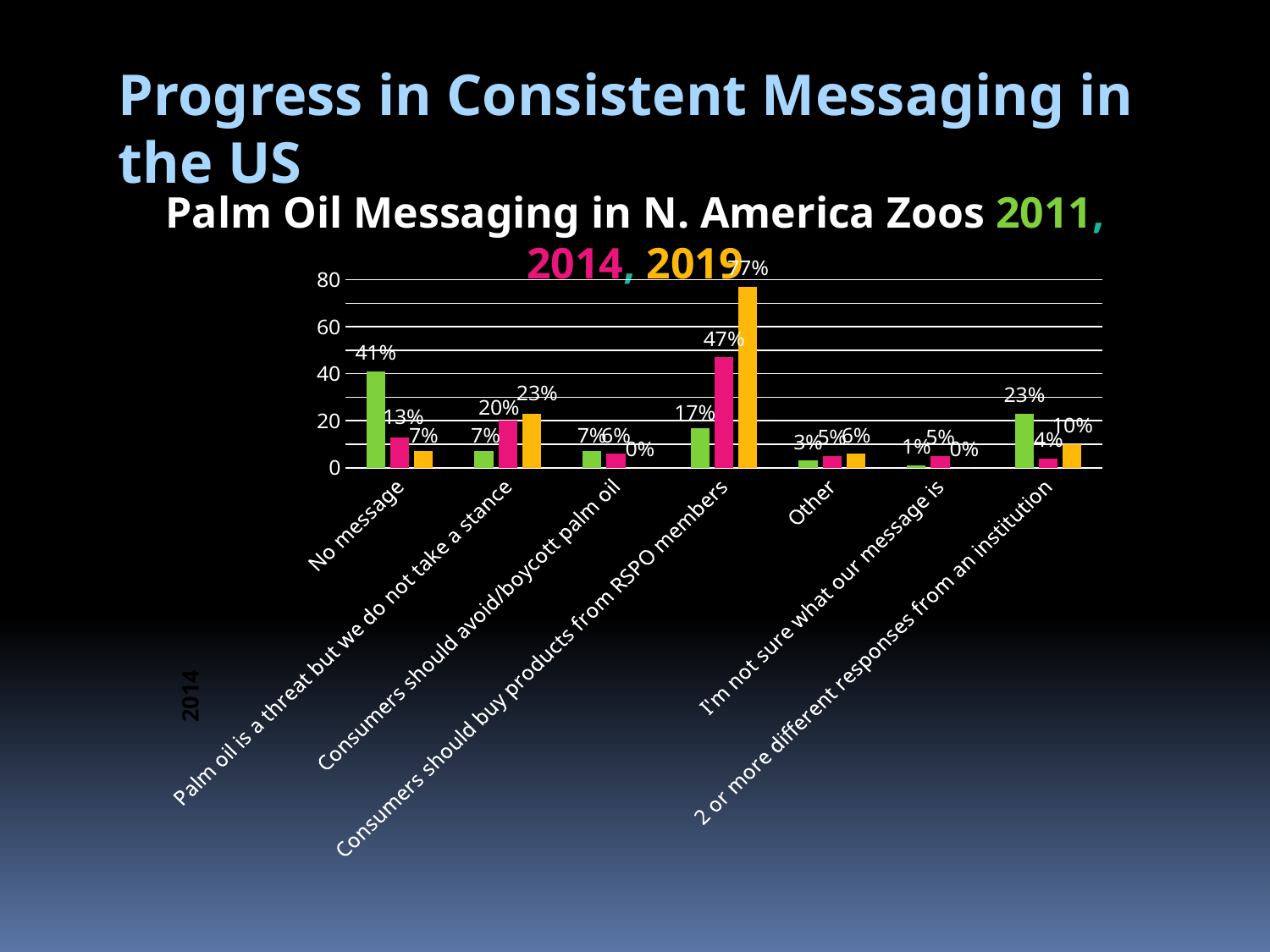
What is the 2014 (pink) value for 'Consumers should buy products from RSPO members'? 47% How many data series (years) does the chart show? 3 What is the 2011 (green) value for 'No message'? 41% Which category has the lowest 2011 (green) value? I'm not sure what our message is What type of chart is shown on the slide? bar chart What is the difference between the 2011 (green) and 2014 (pink) values for 'No message'? 28% What is the 2019 (yellow) value for 'Palm oil is a threat but we do not take a stance'? 23% Which is larger for 'Other': the 2011 (green) value or the 2019 (yellow) value? 2019 (yellow) How many categories are shown along the x axis of the chart? 7 What is the 2011 (green) value for '2 or more different responses from an institution'? 23% Which category has the highest 2014 (pink) value? Consumers should buy products from RSPO members Is the 2019 (yellow) value for 'Consumers should buy products from RSPO members' greater or less than 60? greater